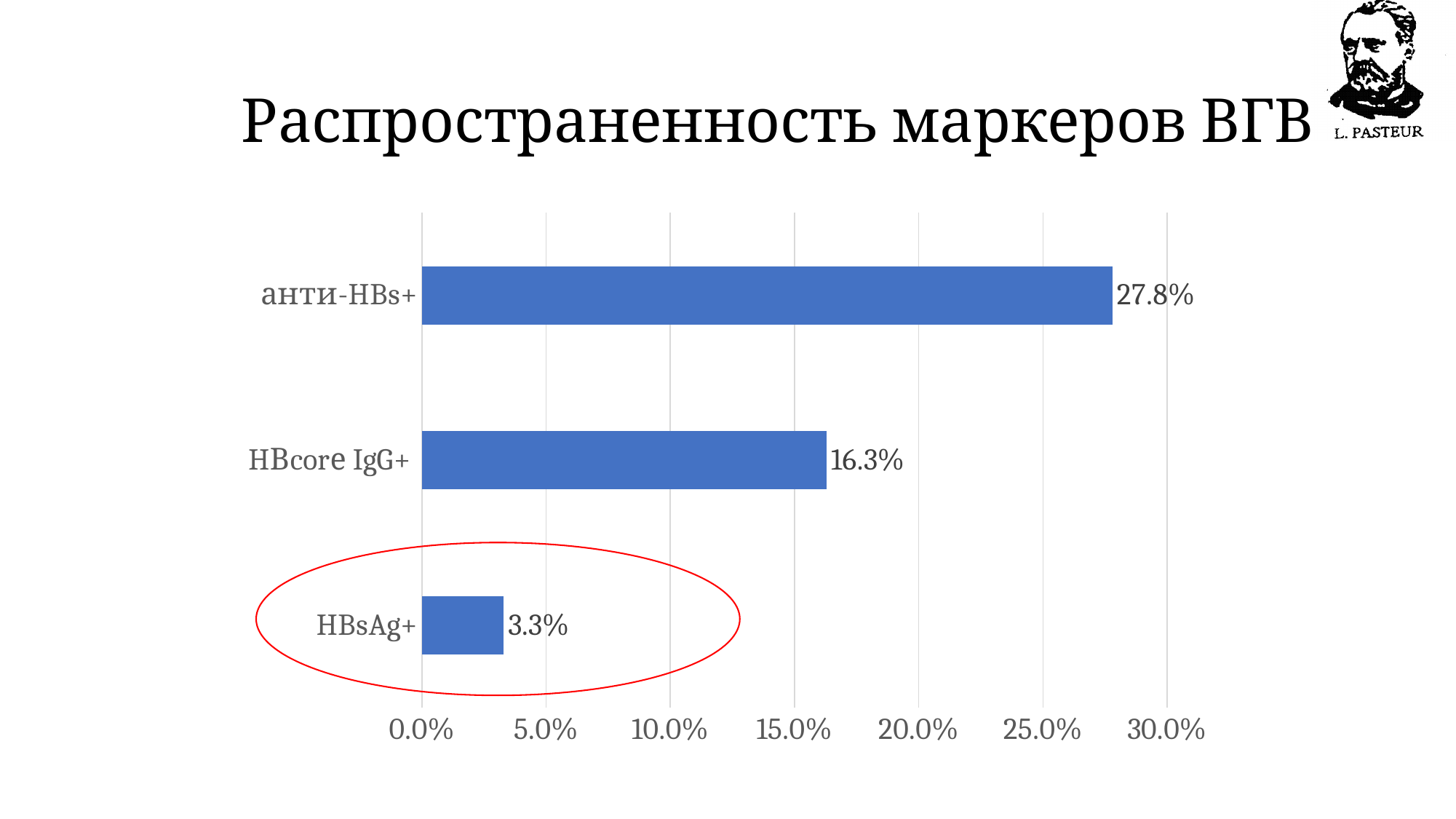
Which marker is circled in red on the chart? HBsAg+ Is the value for анти-HBs+ greater or less than 25.0%? greater What is the value for анти-HBs+? 27.8% What is the difference between the values for анти-HBs+ and HBcore IgG+? 11.5% How many markers are shown in the chart? 3 What is the value for HBcore IgG+? 16.3% Which marker has the lowest value? HBsAg+ Which marker has the highest value? анти-HBs+ Which is larger, the value for HBcore IgG+ or the value for HBsAg+? HBcore IgG+ What is the difference between the values for HBcore IgG+ and HBsAg+? 13.0% What is the value for HBsAg+? 3.3% What kind of chart is shown on the slide? bar chart